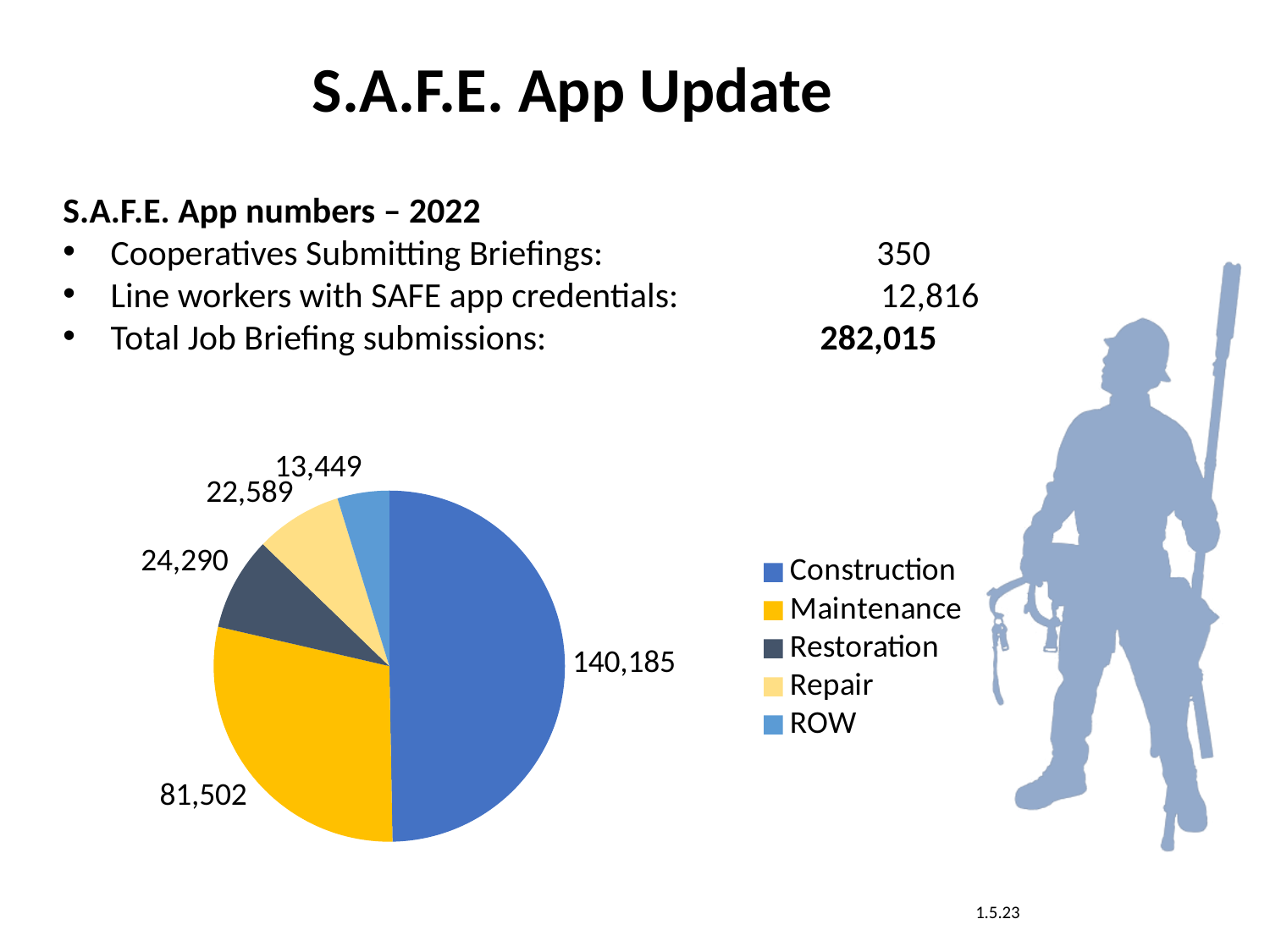
What is the value for Maintenance in the pie chart? 81,502 What is the value for Restoration in the pie chart? 24,290 Which is larger in the pie chart, Restoration or Repair? Restoration How many categories does the pie chart show? 5 What is the difference between the Construction and Maintenance values in the pie chart? 58,683 What is the value for ROW in the pie chart? 13,449 Which category has the smallest slice of the pie chart? ROW What is the total of all slices in the pie chart? 282,015 Which category has the largest slice of the pie chart? Construction What kind of chart is shown on the slide? pie chart Which colour represents Maintenance in the pie chart legend? yellow What is the value for Construction in the pie chart? 140,185